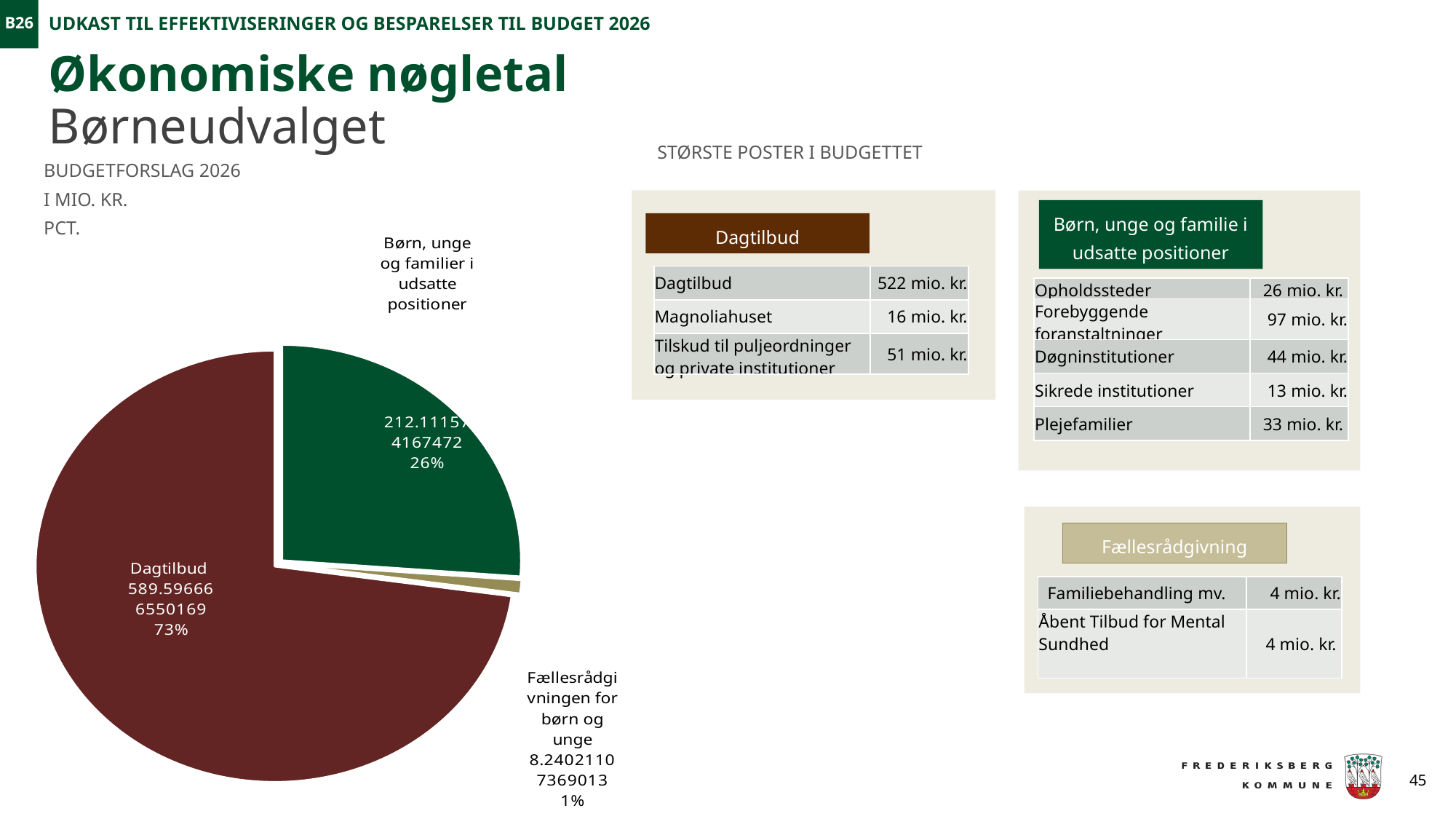
What is the value shown for Fællesrådgivningen for børn og unge in the pie chart? 8.24021107369013 Which slice of the pie chart is the largest? Dagtilbud What share of the pie does Børn, unge og familier i udsatte positioner account for? 26% Which slice of the pie chart is the smallest? Fællesrådgivningen for børn og unge Which is larger in the pie chart: Dagtilbud or Børn, unge og familier i udsatte positioner? Dagtilbud What share of the pie does Dagtilbud account for? 73% What kind of chart is shown on the slide? pie chart What is the difference in percentage points between the Dagtilbud share and the Børn, unge og familier i udsatte positioner share? 47 percentage points What share of the pie does Fællesrådgivningen for børn og unge account for? 1% What colour is the Dagtilbud slice in the pie chart? dark red What is the value shown for Dagtilbud in the pie chart? 589.596666550169 How many slices does the pie chart have? 3